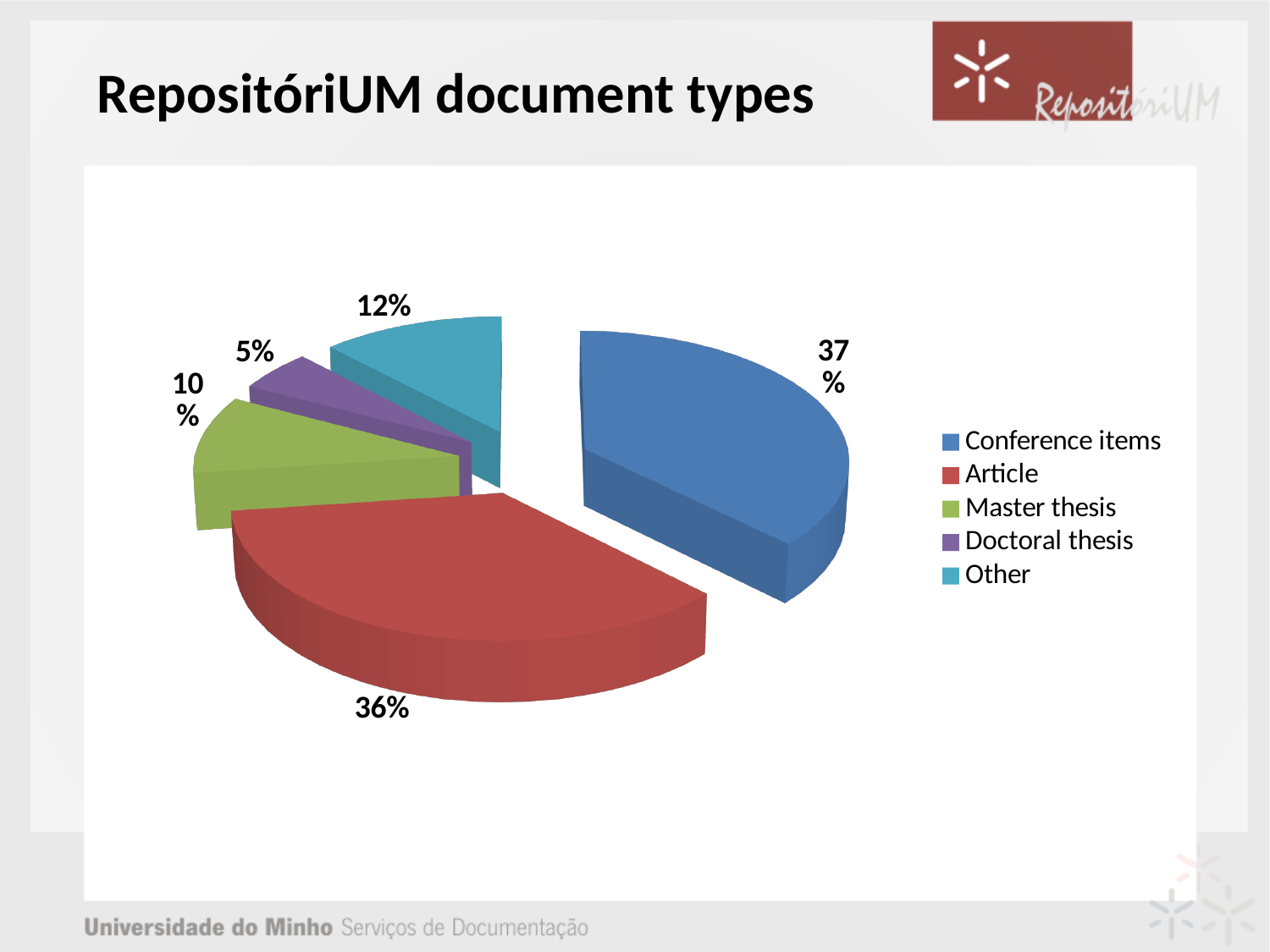
Which colour represents Master thesis in the legend? Green What share of the pie is Conference items? 37% Which is larger, the share for Other or the share for Doctoral thesis? Other What share of the pie is Article? 36% How many categories does the pie chart show? 5 What share of the pie is Doctoral thesis? 5% What is the difference in percentage points between Other and Master thesis? 2 Which category has the smallest slice of the pie? Doctoral thesis What share of the pie is Master thesis? 10% What kind of chart is shown on the slide? Pie chart What share of the pie is Other? 12% Which category has the largest slice of the pie? Conference items